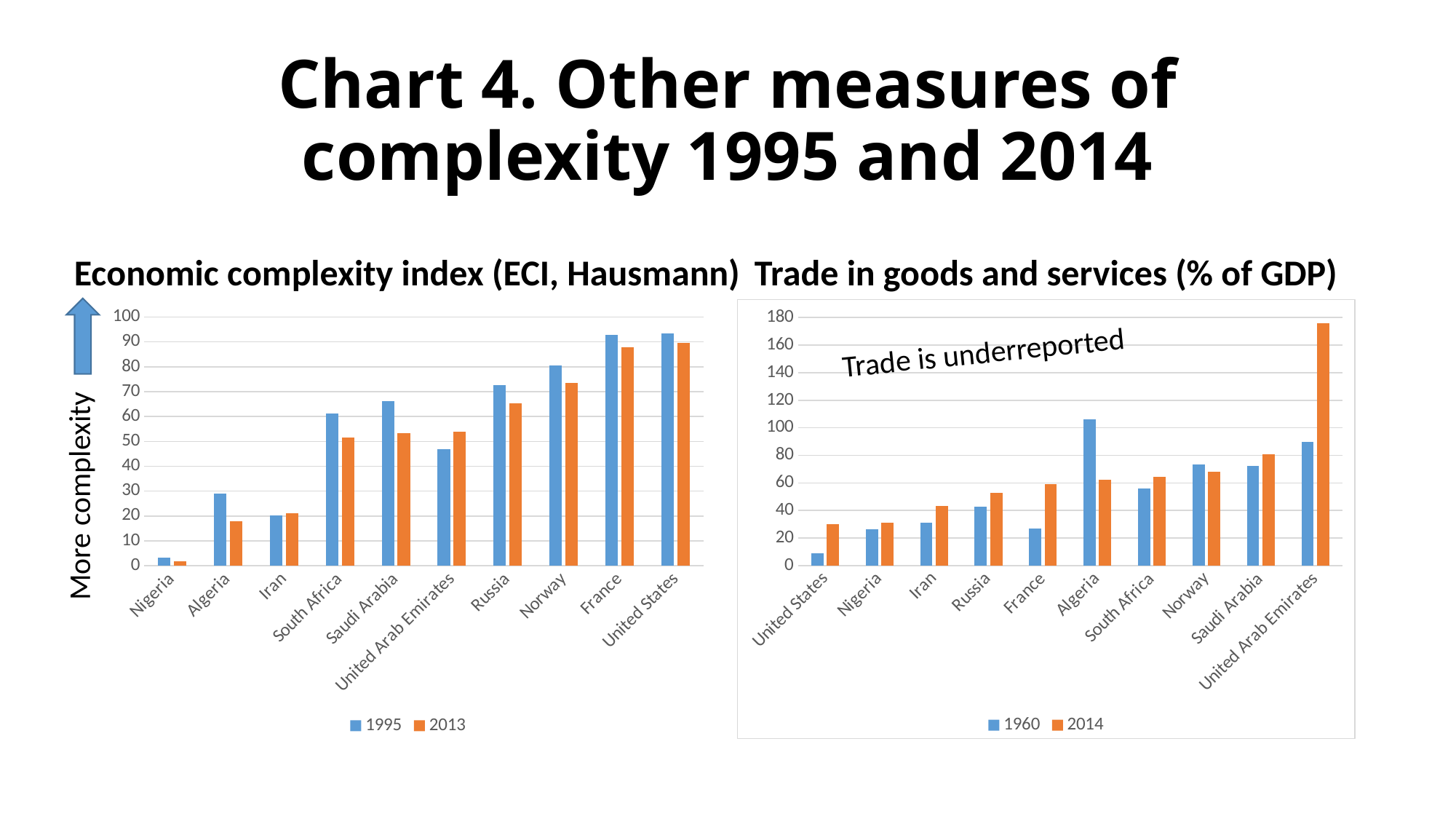
In the Trade in goods and services chart, which country has the lowest value for 1960? United States In the Trade in goods and services chart, which country has the highest value for 1960? Algeria In the Economic complexity index chart, is the 2013 value for Algeria greater or less than 20? less In the Trade in goods and services chart, is the 1960 value for France greater or less than 40? less In the Trade in goods and services chart, which country has the highest value for 2014? United Arab Emirates In the Economic complexity index chart, which is larger for Russia, the 1995 value or the 2013 value? 1995 In the Trade in goods and services chart, is the 2014 value for United Arab Emirates greater or less than 160? greater How many series does the legend of the Trade in goods and services chart list? 2 In the Trade in goods and services chart, which is larger for Norway, the 1960 value or the 2014 value? 1960 How many countries are shown in the Economic complexity index chart? 10 In the Economic complexity index chart, which country has the lowest value for 1995? Nigeria